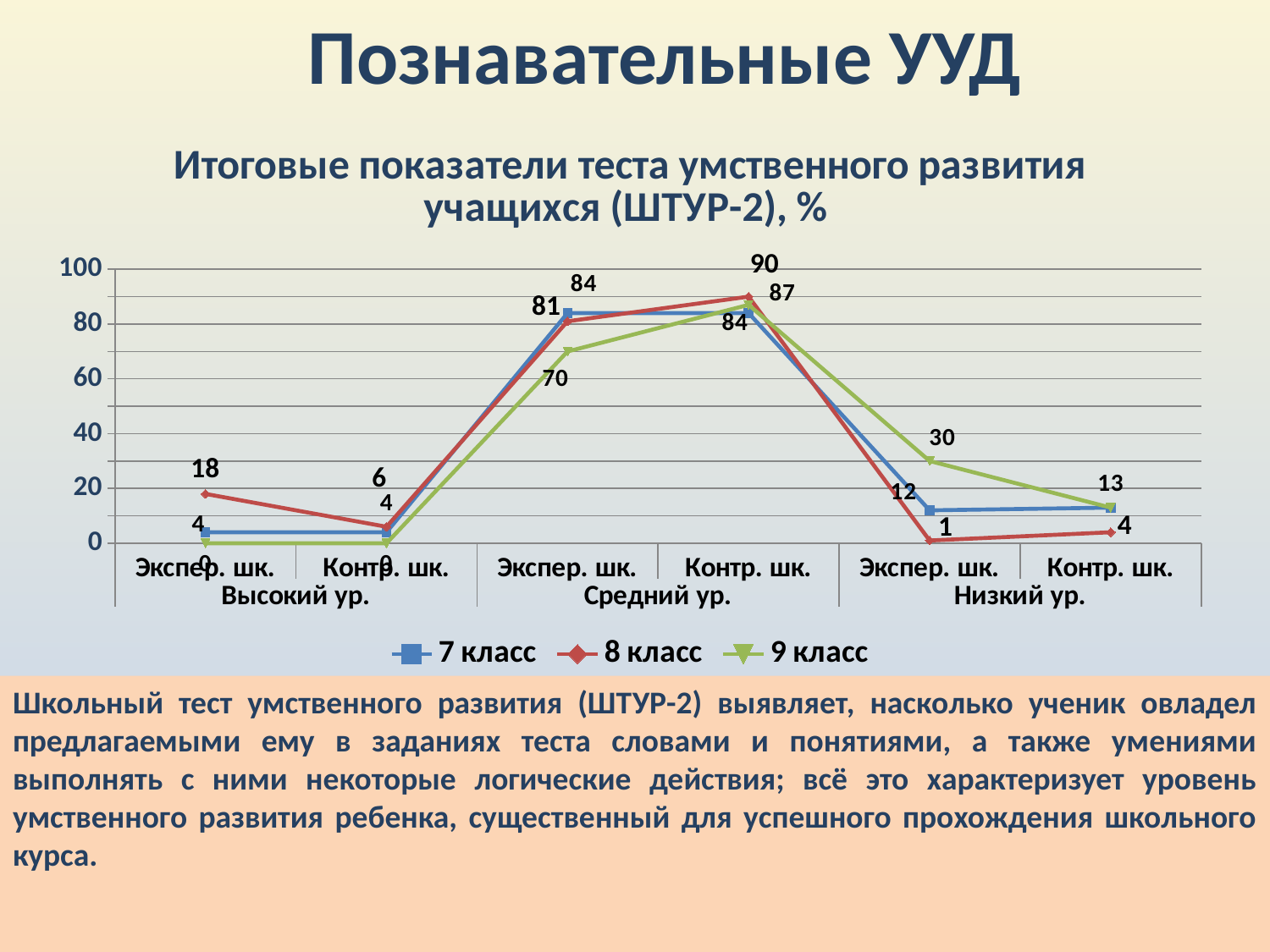
What is the value for 9 класс at Экспер. шк. in the Средний ур. group? 70 At Экспер. шк. in the Низкий ур. group, which series has the larger value, 7 класс or 9 класс? 9 класс What is the difference between the 8 класс values at Экспер. шк. and Контр. шк. in the Высокий ур. group? 12 How many series does the legend list? 3 For the 8 класс series, which category has the highest value? Контр. шк., Средний ур. What is the value for 9 класс at Экспер. шк. in the Низкий ур. group? 30 What is the value for 8 класс at Контр. шк. in the Средний ур. group? 90 What kind of chart is shown on the slide? line chart What is the value for 8 класс at Экспер. шк. in the Высокий ур. group? 18 Which series are listed in the legend? 7 класс, 8 класс, 9 класс What is the value for 9 класс at Контр. шк. in the Средний ур. group? 87 How many categories are plotted along the x axis? 6